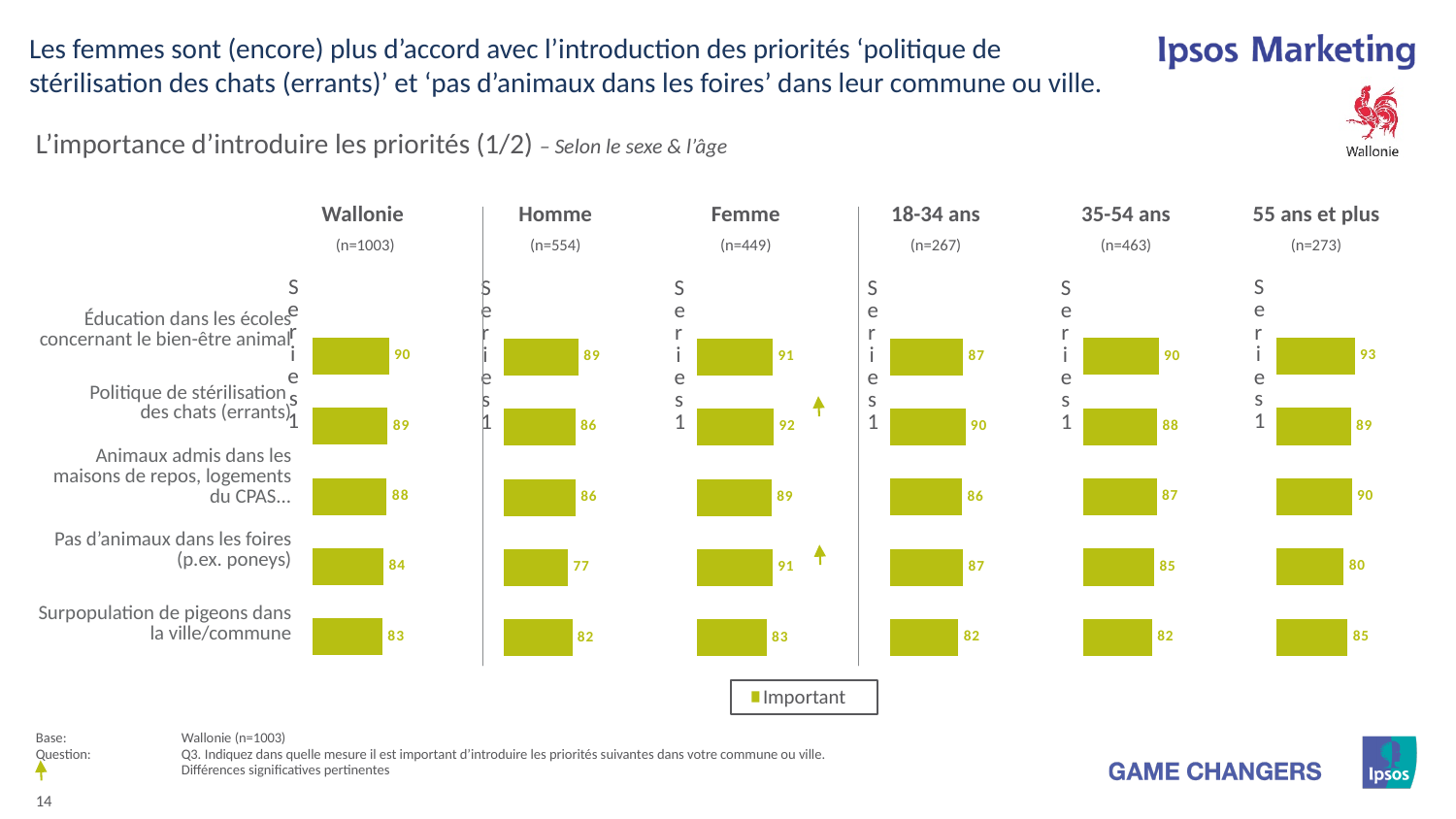
What series name does the legend show? Important For 'Surpopulation de pigeons dans la ville/commune', which is larger: the 55 ans et plus value or the 35-54 ans value? 55 ans et plus How many categories are shown in the Wallonie chart? 5 What is the difference between the Femme and Homme values for 'Pas d'animaux dans les foires (p.ex. poneys)'? 14 In the 55 ans et plus chart, which category has the highest value? Éducation dans les écoles concernant le bien-être animal In the Homme chart, what is the value for 'Pas d'animaux dans les foires (p.ex. poneys)'? 77 In the 18-34 ans chart, which category has the highest value? Politique de stérilisation des chats (errants) What is the sample size (n) shown for the Femme chart? n=449 In the Homme chart, which category has the lowest value? Pas d'animaux dans les foires (p.ex. poneys) In the Femme chart, what is the value for 'Politique de stérilisation des chats (errants)'? 92 In the Wallonie chart, what is the value for 'Éducation dans les écoles concernant le bien-être animal'? 90 What type of chart is used for the Wallonie data? Bar chart